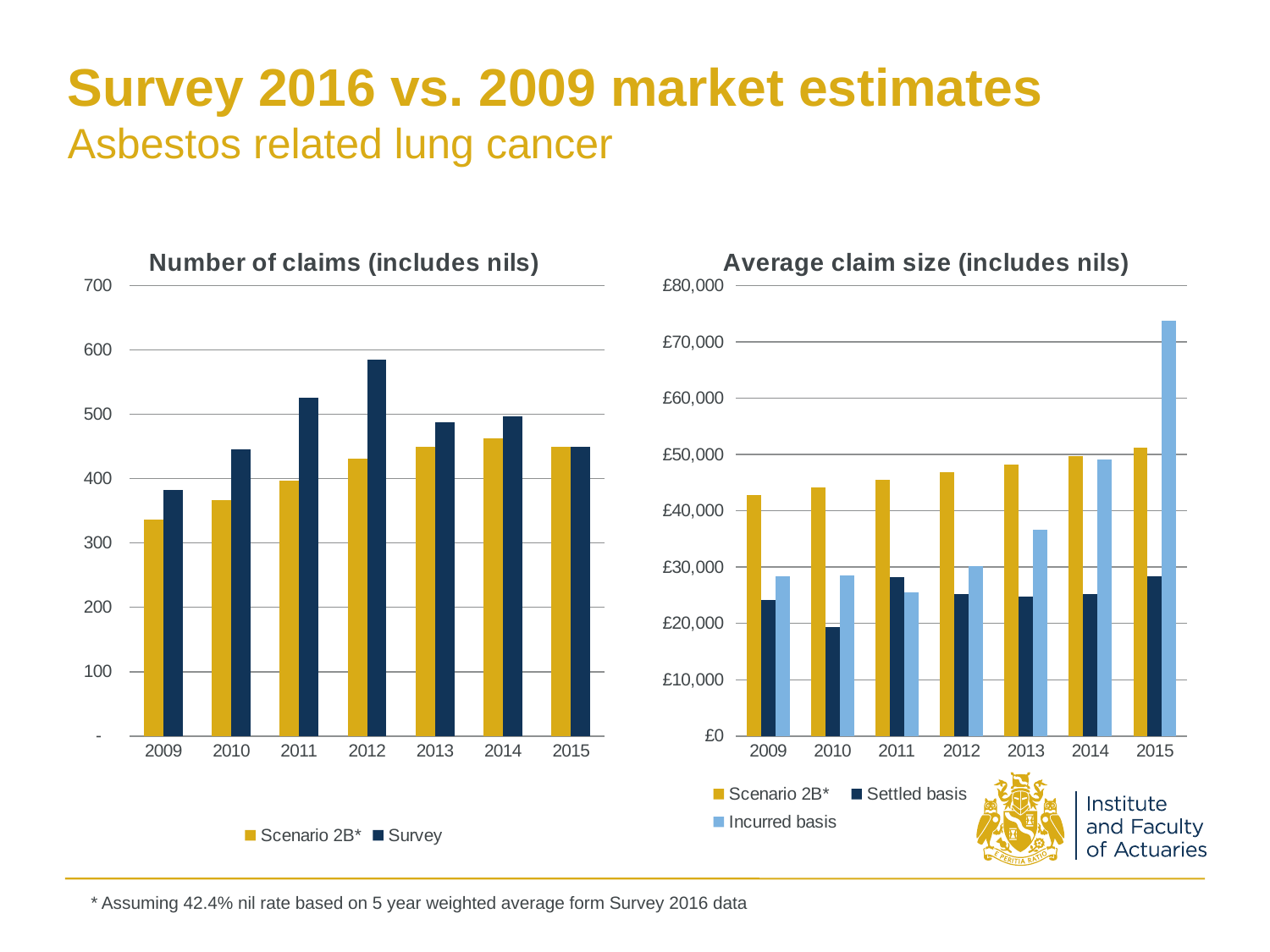
In the 'Number of claims (includes nils)' chart, is the Survey value for 2012 greater or less than 500? greater In the 'Average claim size (includes nils)' chart, do the Scenario 2B* values rise or fall from 2009 to 2015? rise In the 'Average claim size (includes nils)' chart, is the Incurred basis value for 2015 greater or less than £70,000? greater In the 'Number of claims (includes nils)' chart, which year has the highest Survey value? 2012 How many years are shown on the x axis of the 'Number of claims (includes nils)' chart? 7 In the 'Number of claims (includes nils)' chart, which year has the lowest Scenario 2B* value? 2009 What kind of chart is the 'Number of claims (includes nils)' chart? bar chart In the 'Number of claims (includes nils)' chart, is the Scenario 2B* value for 2009 greater or less than 400? less In the 'Average claim size (includes nils)' chart, which year has the highest Incurred basis value? 2015 In the 'Average claim size (includes nils)' chart, which year has the lowest Settled basis value? 2010 How many series does the legend of the 'Average claim size (includes nils)' chart list? 3 In the 'Number of claims (includes nils)' chart, which is larger for 2011: Scenario 2B* or Survey? Survey